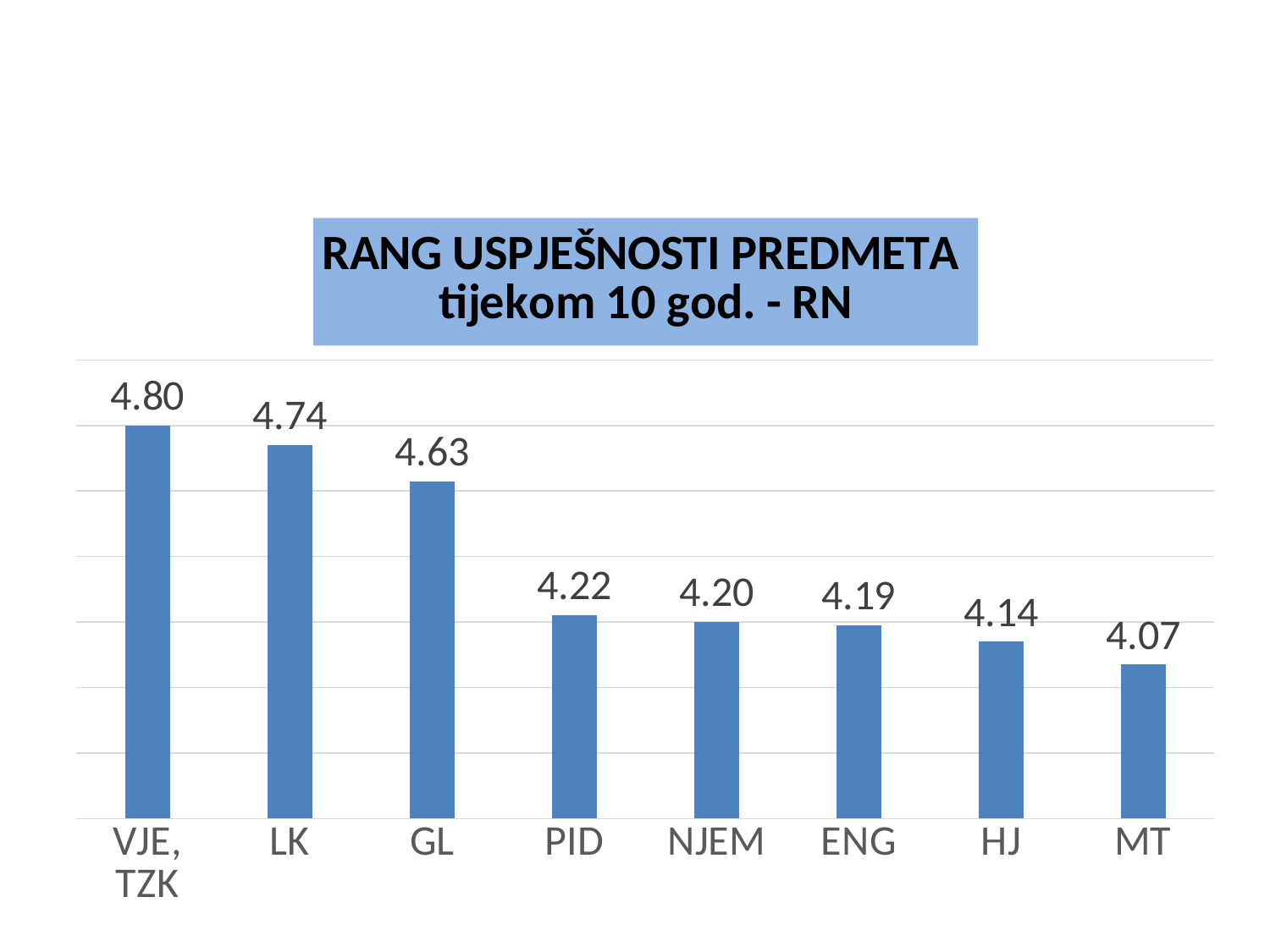
What is the value for HJ? 4.14 What is the difference between the values for LK and GL? 0.11 What is the value for GL? 4.63 What is the difference between the values for VJE, TZK and MT? 0.73 Which is larger, the value for PID or the value for HJ? PID How many categories are shown on the x axis? 8 What is the value for NJEM? 4.20 Do the values rise or fall from left to right along the x axis? fall Which category has the highest value? VJE, TZK What is the title of the chart? RANG USPJEŠNOSTI PREDMETA tijekom 10 god. - RN What kind of chart is this? bar chart Which category has the lowest value? MT